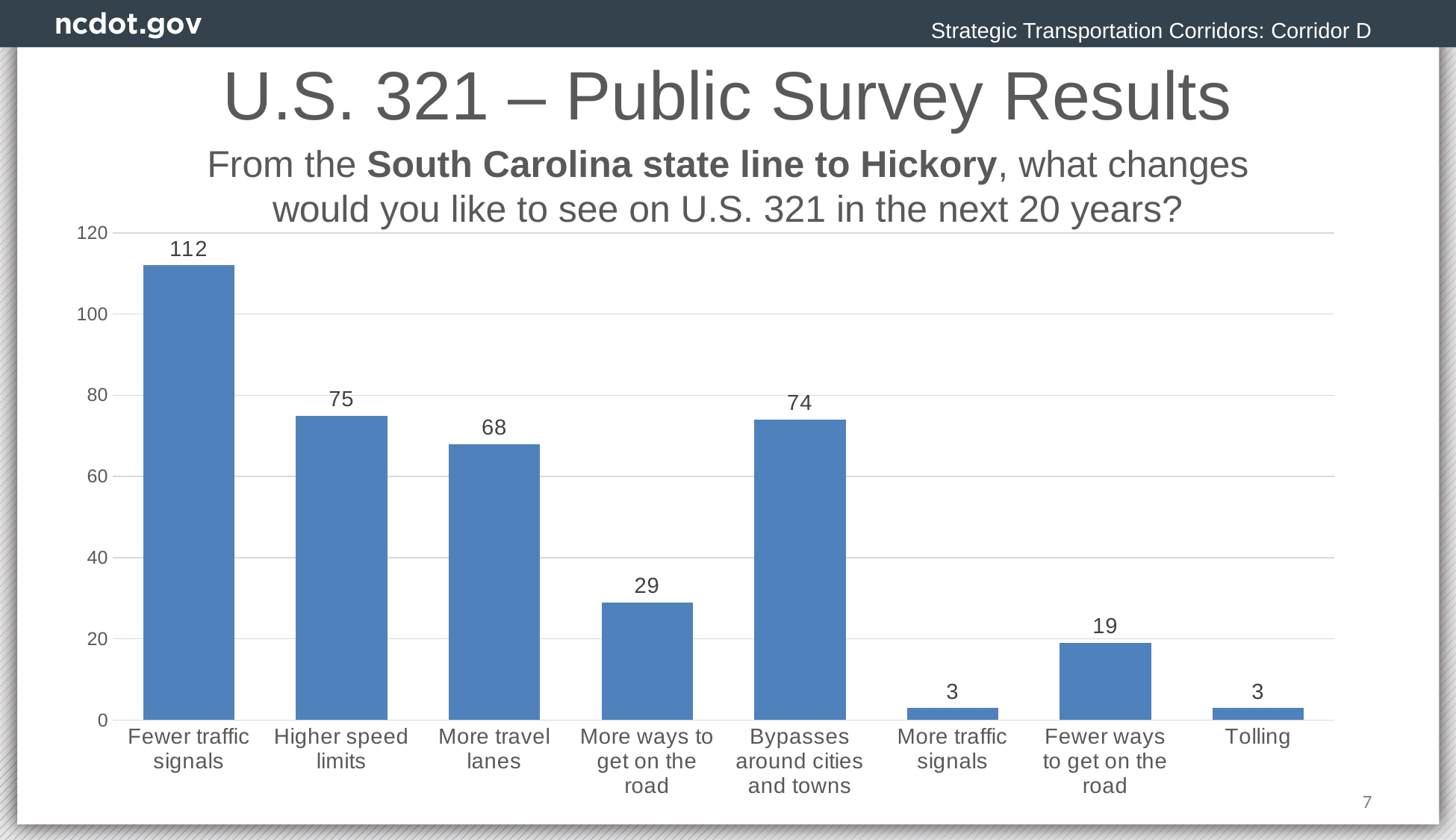
What is the value for Fewer ways to get on the road? 19 How many categories are shown on the x axis? 8 Which is larger, the value for More ways to get on the road or the value for Fewer ways to get on the road? More ways to get on the road What is the difference between the values for Fewer traffic signals and Bypasses around cities and towns? 38 Which category has the highest value? Fewer traffic signals What is the value for Bypasses around cities and towns? 74 What is the title of the slide containing the chart? U.S. 321 – Public Survey Results Is the value for More travel lanes greater or less than 60? greater What is the value for Tolling? 3 What is the difference between the values for Higher speed limits and More travel lanes? 7 What is the value for Fewer traffic signals? 112 What kind of chart is shown on the slide? bar chart